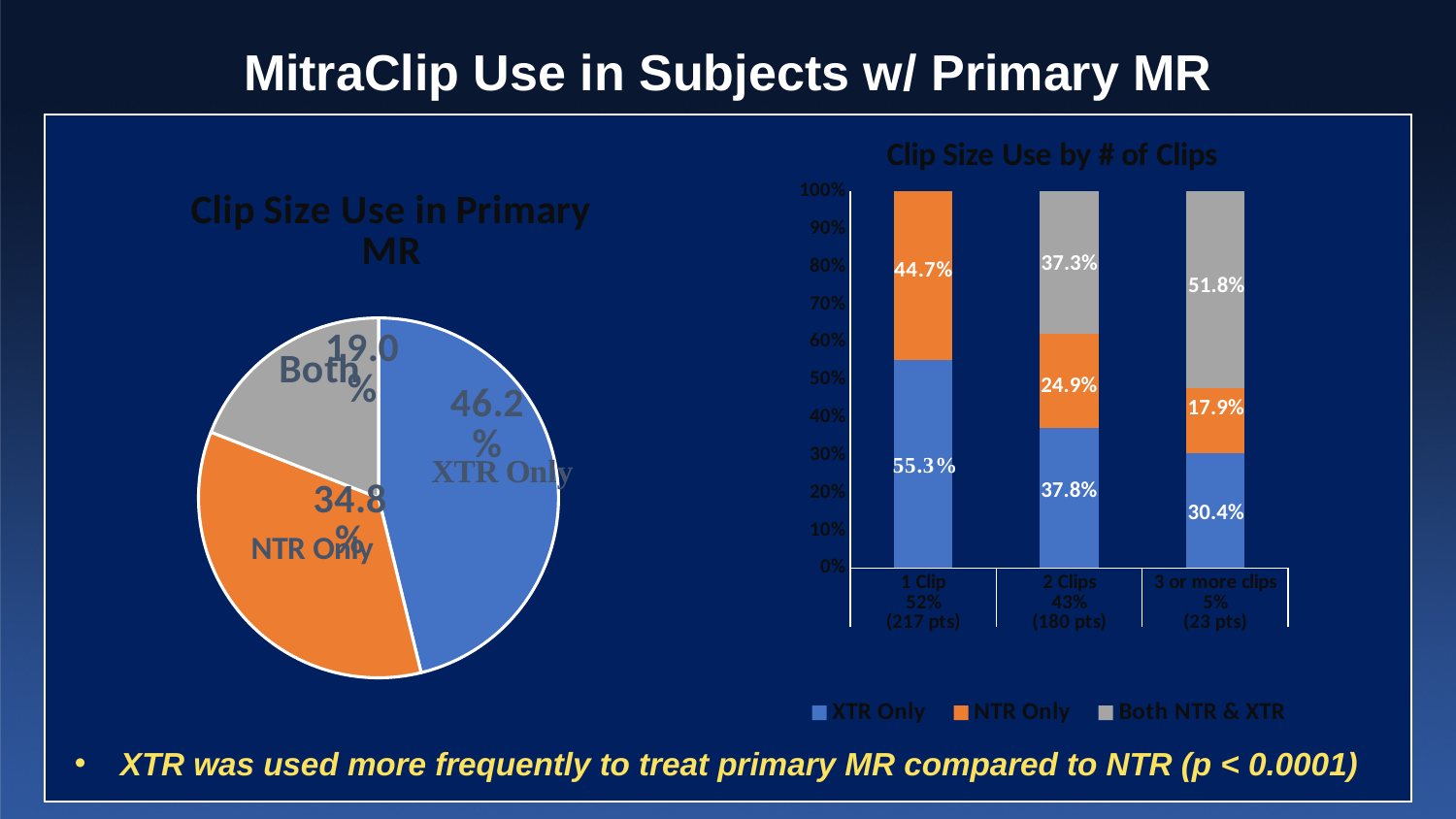
In the 'Clip Size Use by # of Clips' chart, what is the difference between the XTR Only values for 1 Clip and 2 Clips? 17.5% In the 'Clip Size Use in Primary MR' pie chart, which slice is the smallest? Both How many series does the legend of the 'Clip Size Use by # of Clips' chart list? 3 What kind of chart is 'Clip Size Use in Primary MR'? Pie chart In the 'Clip Size Use in Primary MR' pie chart, what share is labelled for NTR Only? 34.8% In the 'Clip Size Use in Primary MR' pie chart, what share is labelled for XTR Only? 46.2% In the 'Clip Size Use in Primary MR' pie chart, how many slices are there? 3 In the 'Clip Size Use by # of Clips' chart, what is the NTR Only value for 2 Clips? 24.9% In the 'Clip Size Use by # of Clips' chart, how does the XTR Only value change from 1 Clip to 3 or more clips? It falls What kind of chart is 'Clip Size Use by # of Clips'? Stacked bar chart In the 'Clip Size Use by # of Clips' chart, what is the Both NTR & XTR value for 3 or more clips? 51.8% In the 'Clip Size Use by # of Clips' chart, what is the XTR Only value for 1 Clip? 55.3%